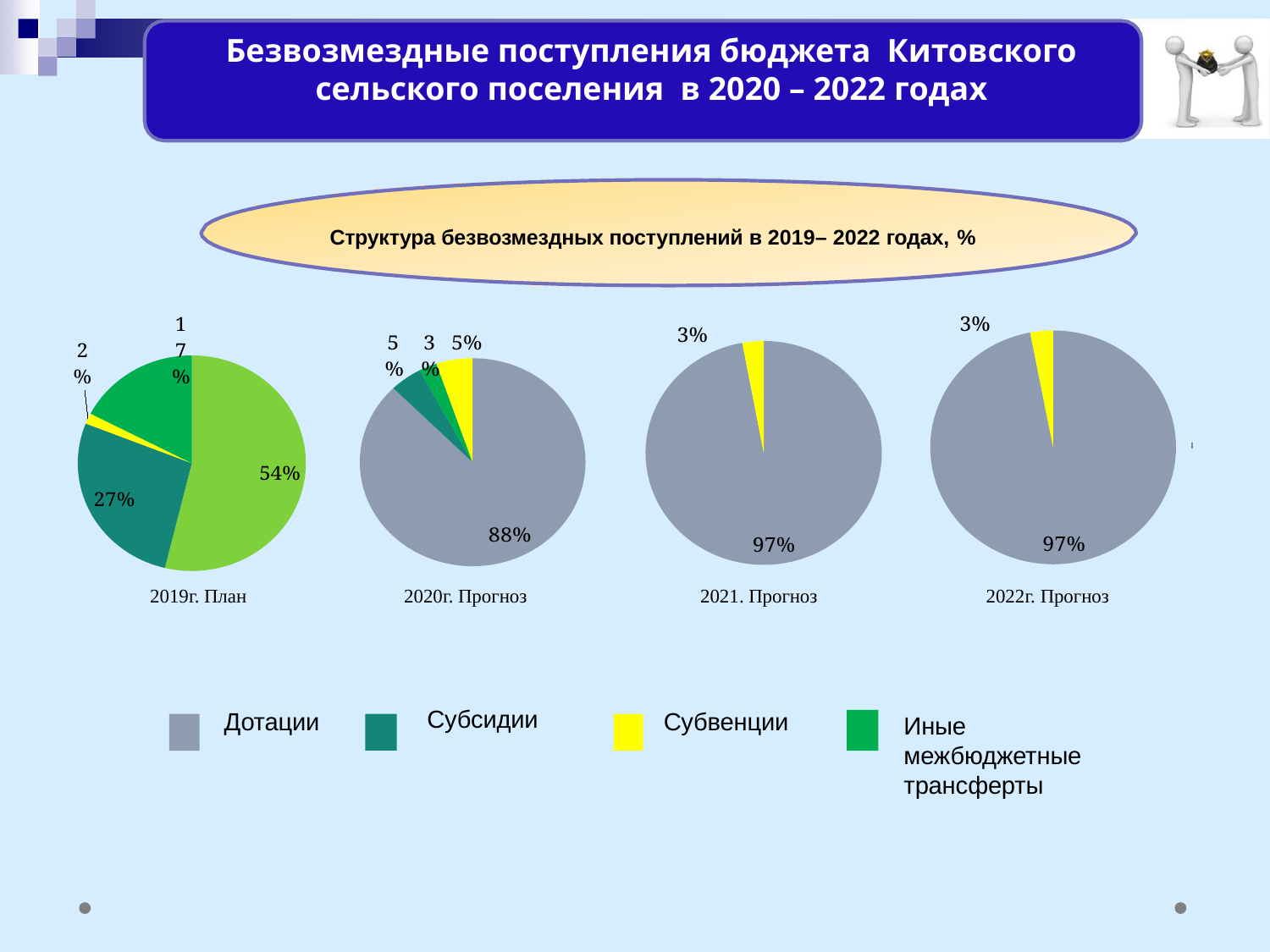
In the 2019г. План pie chart, what is the difference between the largest slice (54%) and the Субсидии slice (27%)? 27 percentage points In the 2019г. План pie chart, what is the value of the largest slice? 54% In the 2019г. План pie chart, what share is Субсидии? 27% In the 2019г. План pie chart, what share is Иные межбюджетные трансферты? 17% In the 2021. Прогноз pie chart, what share is Дотации? 97% What kind of charts are shown on the slide? Pie charts Is the Дотации share larger in the 2020г. Прогноз pie chart or in the 2021. Прогноз pie chart? 2021. Прогноз How many pie charts are shown on the slide? 4 What colour does the legend use for Субвенции? Yellow How many categories does the legend list? 4 In the 2020г. Прогноз pie chart, what share is Дотации? 88% In the 2022г. Прогноз pie chart, what share is Субвенции? 3%